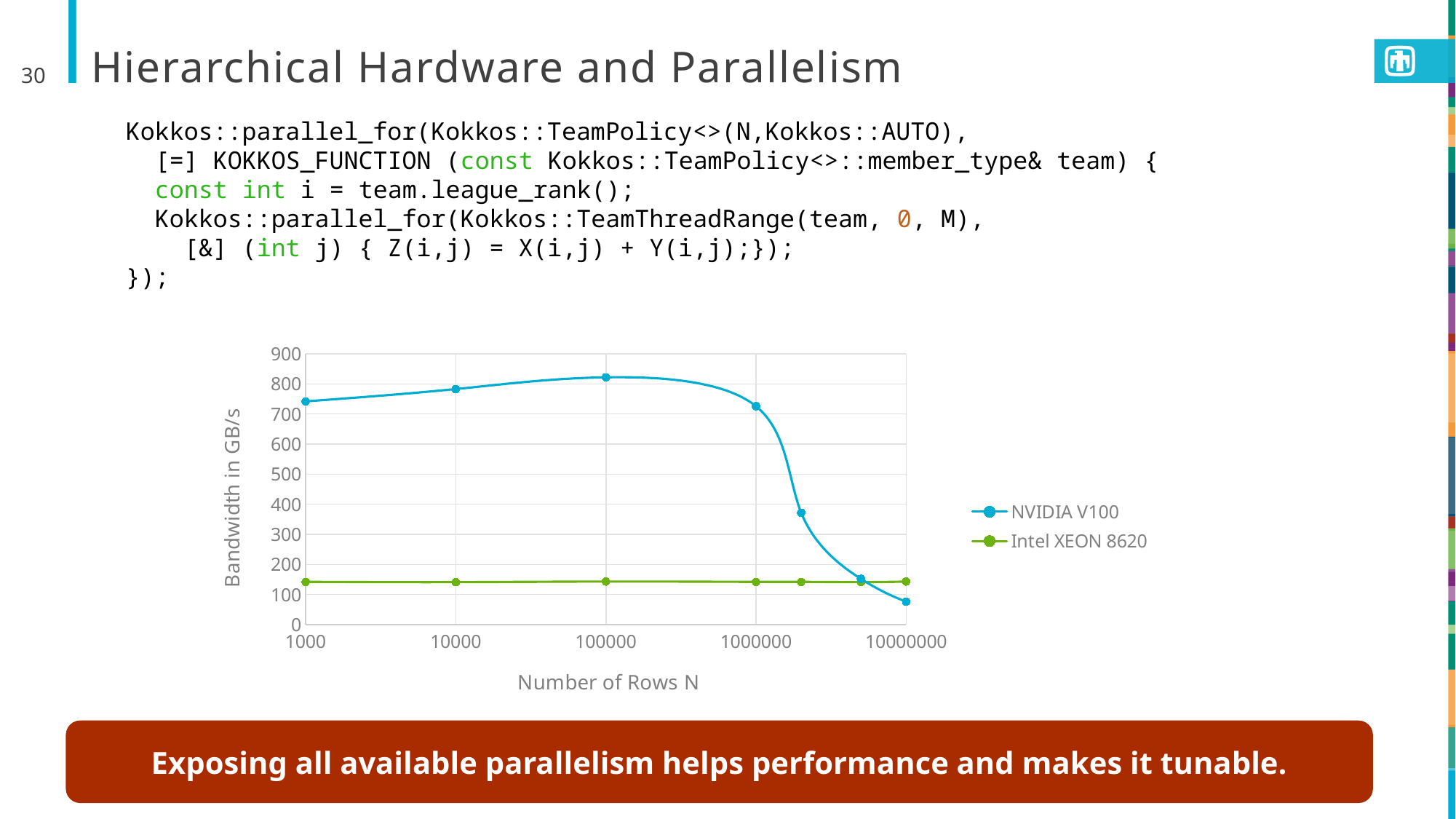
Is the Intel XEON 8620 bandwidth at 1000 rows greater or less than 200? less At 1000 rows, which series has the higher bandwidth, NVIDIA V100 or Intel XEON 8620? NVIDIA V100 What is the label of the chart's y axis? Bandwidth in GB/s What kind of chart is shown on the slide? line chart Which series reaches the highest bandwidth anywhere on the chart? NVIDIA V100 Is the NVIDIA V100 bandwidth at 10000000 rows greater or less than 100? less How many series does the chart legend list? 2 What are the two series named in the chart legend? NVIDIA V100 and Intel XEON 8620 At 10000000 rows, which series has the higher bandwidth, NVIDIA V100 or Intel XEON 8620? Intel XEON 8620 Does the NVIDIA V100 bandwidth rise or fall as the number of rows increases from 1000000 to 10000000? fall Is the NVIDIA V100 bandwidth at 1000 rows greater or less than 700? greater How many data points are plotted for the NVIDIA V100 series? 7